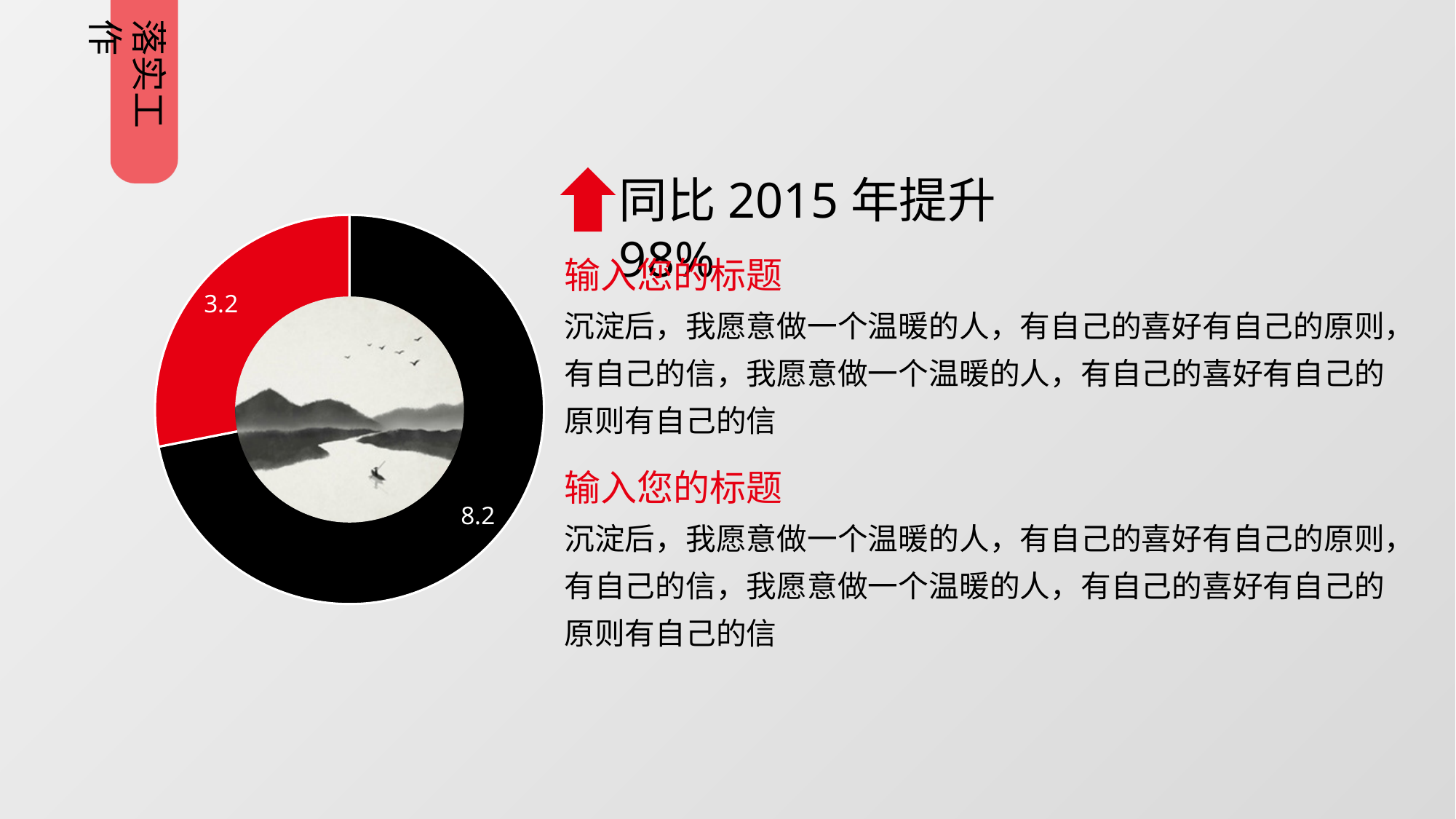
What colour is the slice labelled 3.2 in the doughnut chart? Red How many slices does the doughnut chart have? 2 What is the difference between the black slice value and the red slice value in the doughnut chart? 5.0 What value is labelled on the black slice of the doughnut chart? 8.2 What value is labelled on the red slice of the doughnut chart? 3.2 Which slice of the doughnut chart has the smallest value? The red slice (3.2) Is the black slice or the red slice larger in the doughnut chart? The black slice What kind of chart is shown on the left of the slide? Doughnut chart What is shown in the centre hole of the doughnut chart? An ink-wash landscape painting What is the total of the two values shown in the doughnut chart? 11.4 Which slice of the doughnut chart has the largest value? The black slice (8.2)